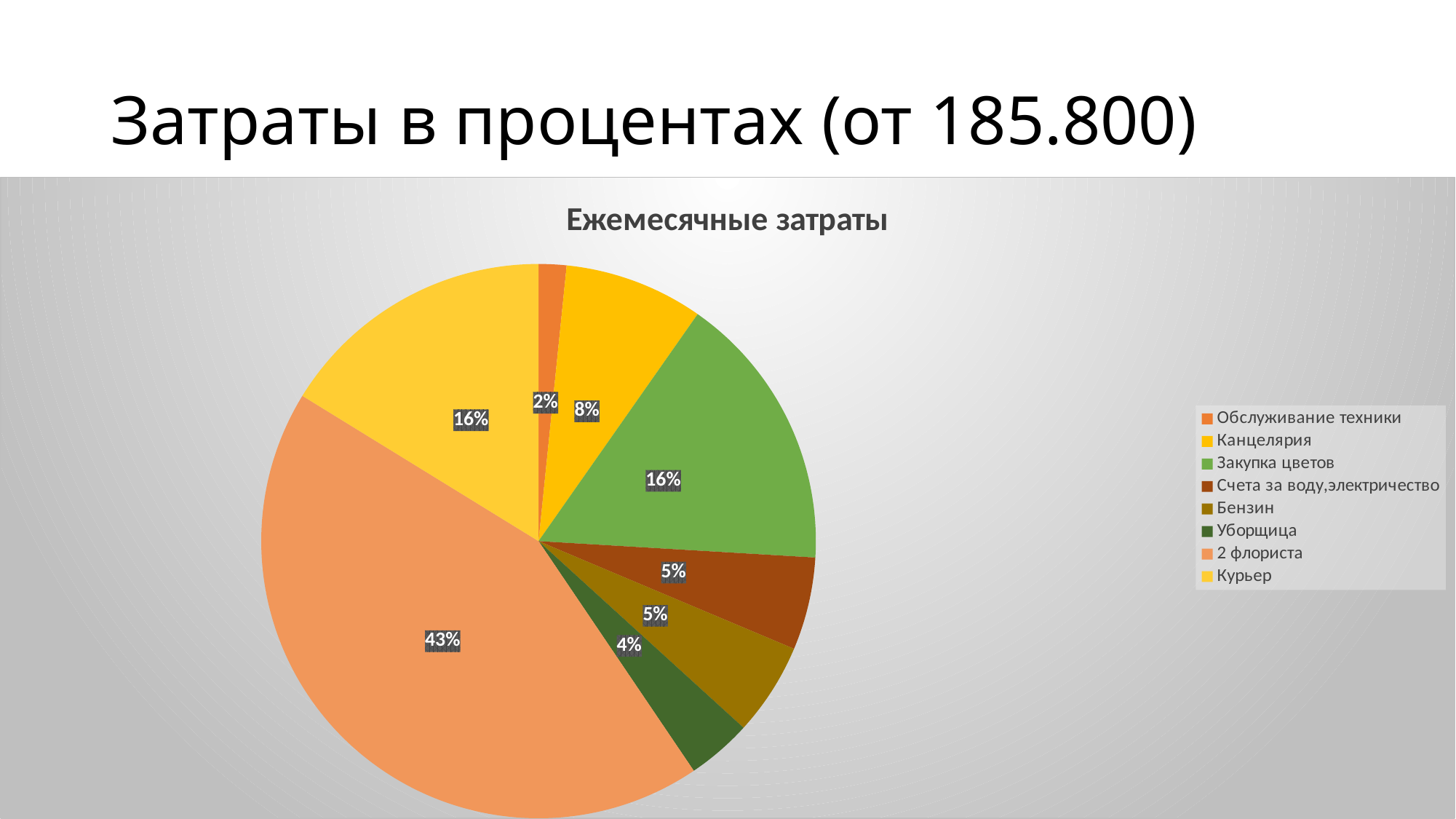
Which is larger, the slice for "Канцелярия" or the slice for "Бензин"? Канцелярия What share of the pie does "2 флориста" take? 43% What share of the pie does "Обслуживание техники" take? 2% What share of the pie does "Закупка цветов" take? 16% What kind of chart is shown on the slide? pie chart Which category has the largest slice of the pie? 2 флориста What is the title of the chart? Ежемесячные затраты What is the difference in percentage points between "2 флориста" and "Курьер"? 27 How many categories does the legend list? 8 Which category has the smallest slice of the pie? Обслуживание техники